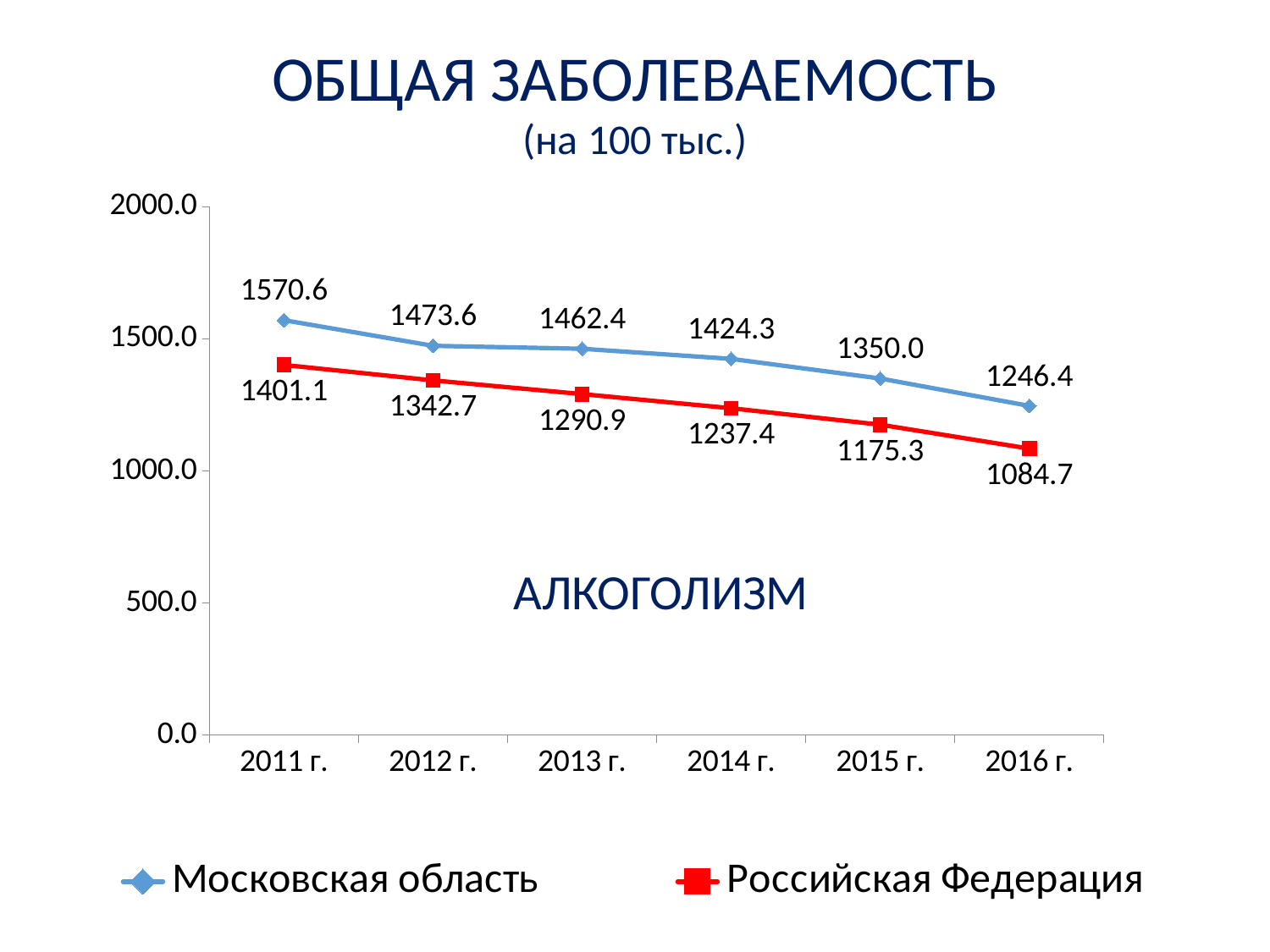
In which year is the value for Российская Федерация lowest? 2016 г. What is the value for Российская Федерация in 2013 г.? 1290.9 What is the value for Московская область in 2015 г.? 1350.0 Which series has the larger value in 2012 г., Московская область or Российская Федерация? Московская область What is the value for Московская область in 2011 г.? 1570.6 How many series does the legend list? 2 What is the difference between Московская область and Российская Федерация in 2014 г.? 186.9 In which year is the value for Московская область highest? 2011 г. Is the value for Российская Федерация in 2011 г. greater or less than 1500.0? less How many years are shown on the x axis? 6 What kind of chart is shown on the slide? line chart What is the value for Российская Федерация in 2016 г.? 1084.7